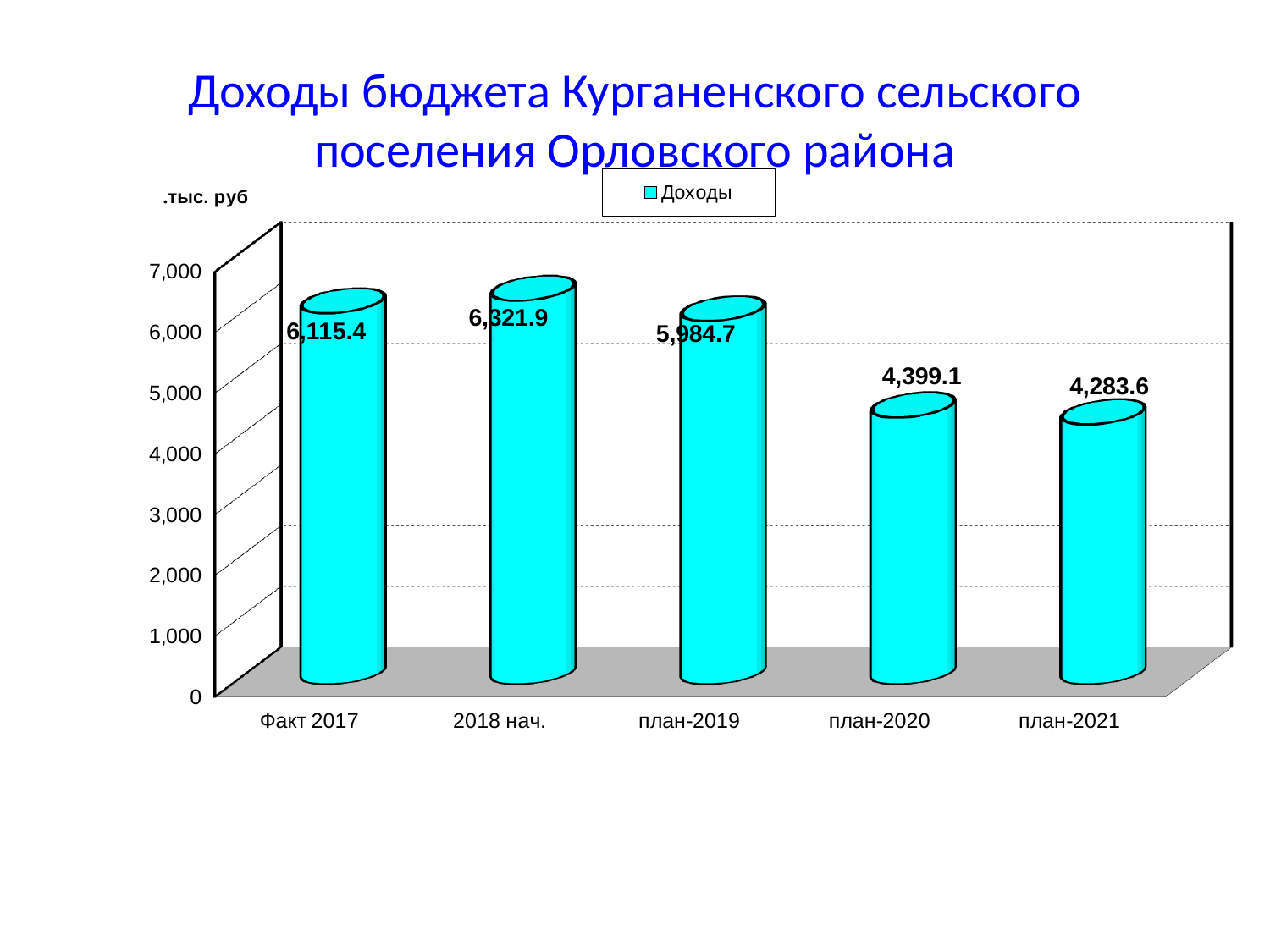
Which is larger, the value for план-2019 or the value for план-2020? план-2019 What is the difference between the values for 2018 нач. and план-2021? 2,038.3 Which category has the highest value? 2018 нач. What is the value for план-2020? 4,399.1 How many categories are shown on the x axis? 5 What kind of chart is shown on the slide? bar chart Is the value for план-2020 greater or less than 5,000? less Which category has the lowest value? план-2021 What is the value for Факт 2017? 6,115.4 What is the value for план-2021? 4,283.6 What series name does the legend show? Доходы What is the difference between the values for 2018 нач. and Факт 2017? 206.5